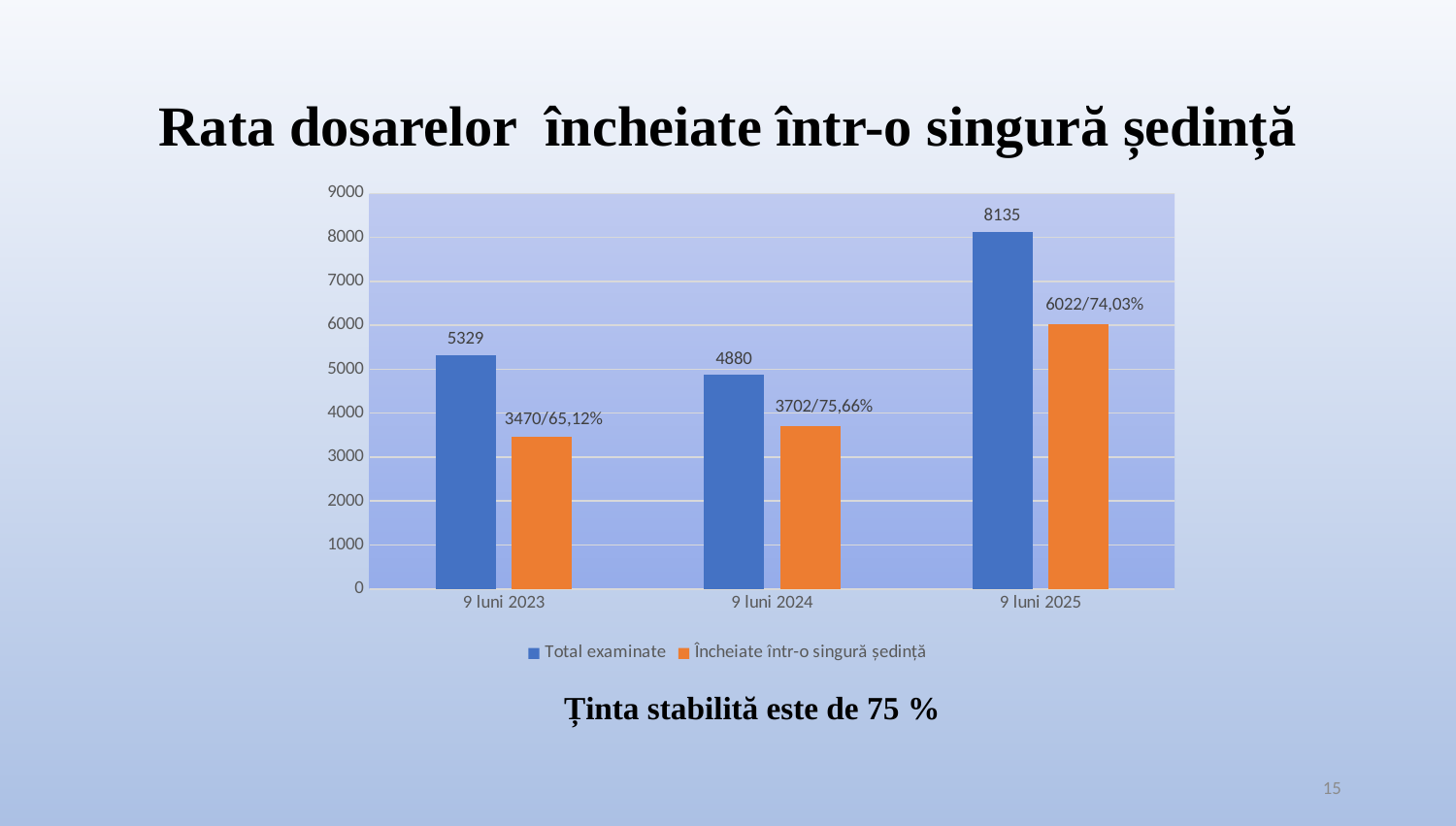
What is the data label on the Încheiate într-o singură ședință bar for 9 luni 2025? 6022/74,03% Which period has the lowest Total examinate value? 9 luni 2024 What is the value of Total examinate for 9 luni 2025? 8135 What is the difference between Total examinate for 9 luni 2025 and 9 luni 2023? 2806 Is the Total examinate value for 9 luni 2025 greater or less than 8000? greater Which period has the highest Total examinate value? 9 luni 2025 What is the value of Total examinate for 9 luni 2023? 5329 How many periods are shown on the x axis? 3 What is the data label on the Încheiate într-o singură ședință bar for 9 luni 2024? 3702/75,66% What type of chart is shown on the slide? Bar chart How many series does the legend list? 2 Which is larger: Total examinate for 9 luni 2023 or for 9 luni 2024? 9 luni 2023